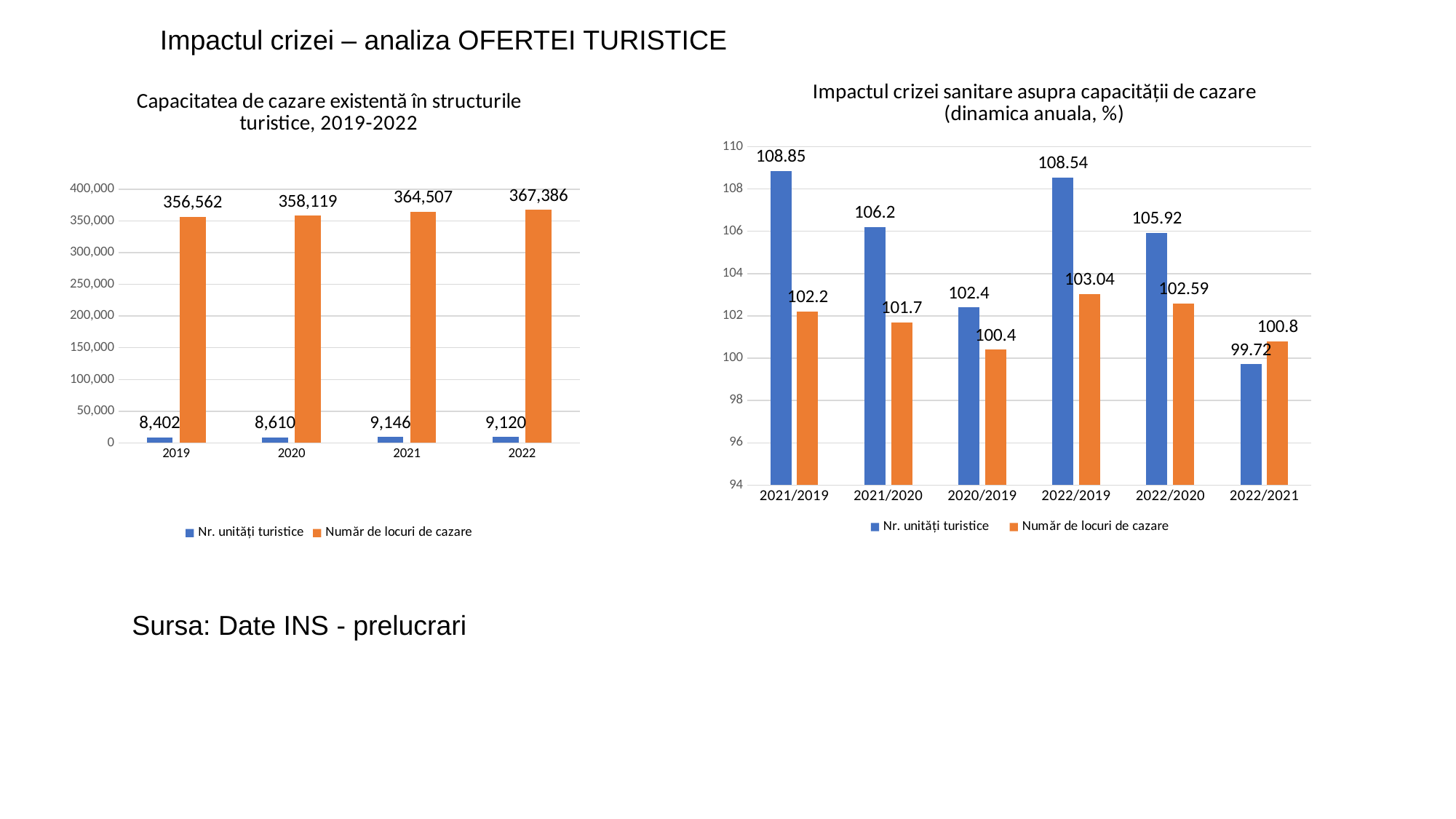
In the left chart (Capacitatea de cazare existentă în structurile turistice, 2019-2022), does Număr de locuri de cazare rise or fall from 2019 to 2022? rise In the right chart (Impactul crizei sanitare asupra capacității de cazare), which is larger for 2021/2020: Nr. unități turistice or Număr de locuri de cazare? Nr. unități turistice In the left chart (Capacitatea de cazare existentă în structurile turistice, 2019-2022), what is the difference between Număr de locuri de cazare in 2022 and in 2019? 10,824 In the left chart (Capacitatea de cazare existentă în structurile turistice, 2019-2022), which year has the highest value for Nr. unități turistice? 2021 In the right chart (Impactul crizei sanitare asupra capacității de cazare), what is the value of Număr de locuri de cazare for 2020/2019? 100.4 In the left chart (Capacitatea de cazare existentă în structurile turistice, 2019-2022), what is the value of Număr de locuri de cazare for 2021? 364,507 In the right chart (Impactul crizei sanitare asupra capacității de cazare), how many series does the legend list? 2 In the left chart (Capacitatea de cazare existentă în structurile turistice, 2019-2022), what is the value of Nr. unități turistice for 2020? 8,610 What kind of chart is the right chart (Impactul crizei sanitare asupra capacității de cazare)? bar chart In the right chart (Impactul crizei sanitare asupra capacității de cazare), what is the value of Nr. unități turistice for 2022/2019? 108.54 In the right chart (Impactul crizei sanitare asupra capacității de cazare), which category has the lowest value for Nr. unități turistice? 2022/2021 In the left chart (Capacitatea de cazare existentă în structurile turistice, 2019-2022), how many years are shown on the x axis? 4